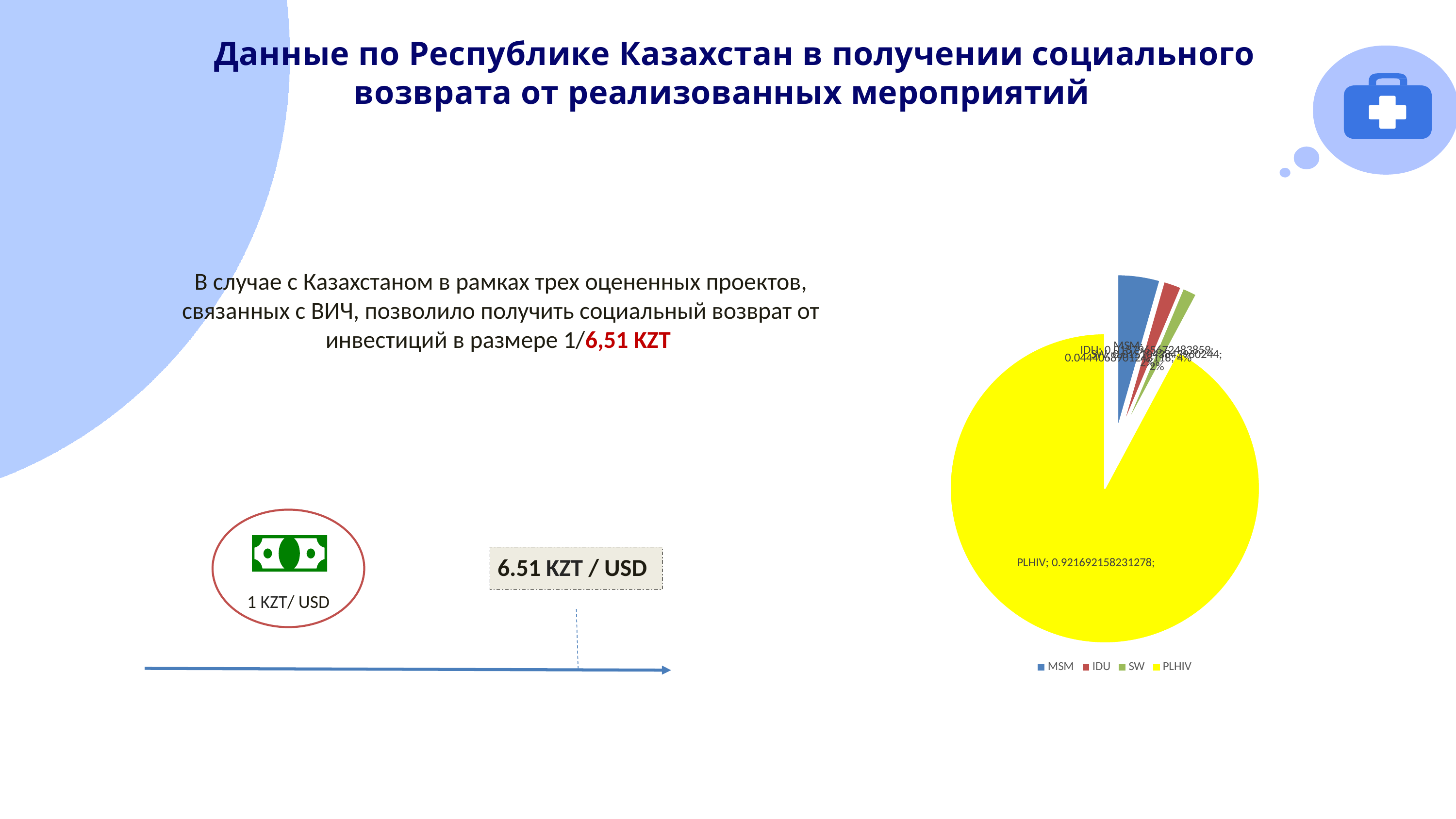
How many slices does the pie chart have? 4 Which categories are listed in the legend of the pie chart, in order? MSM, IDU, SW, PLHIV What value is printed on the PLHIV slice of the pie chart? 0.921692158231278 How many categories does the legend of the pie chart list? 4 What kind of chart is shown on the right side of the slide? pie chart Which slice is larger in the pie chart, MSM or SW? MSM What colour is the PLHIV slice in the pie chart? yellow Which category has the largest slice in the pie chart? PLHIV Which slice is larger in the pie chart, PLHIV or MSM? PLHIV